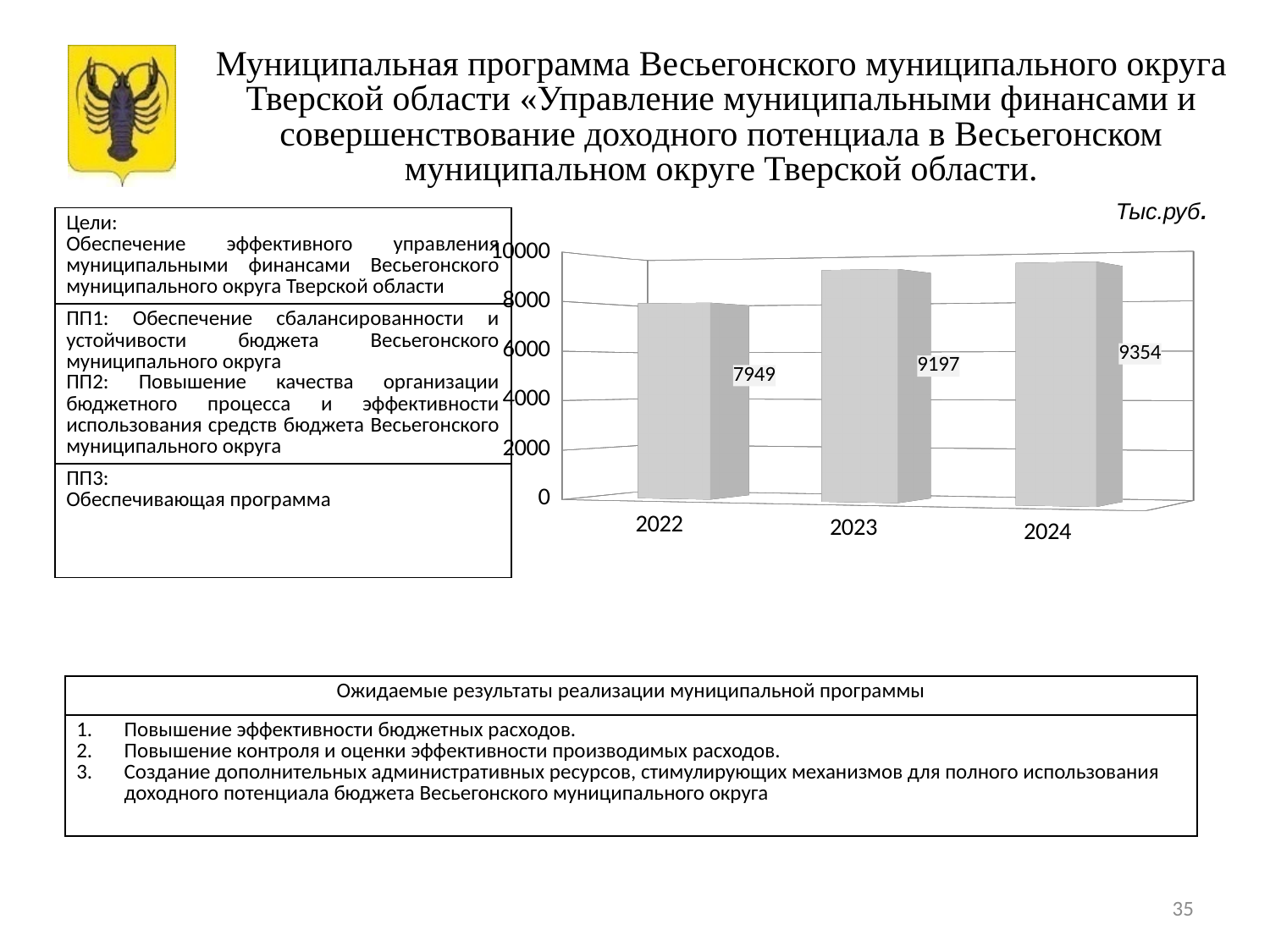
What is the difference between the values for 2024 and 2023? 157 What is the value for 2024? 9354 Is the value for 2022 greater or less than 8000? less Which is larger, the value for 2022 or the value for 2023? 2023 What kind of chart is shown on the slide? bar chart Do the values rise or fall from 2022 to 2024? rise What is the difference between the values for 2023 and 2022? 1248 How many years are shown on the chart? 3 What is the value for 2023? 9197 What is the value for 2022? 7949 Which year has the highest value? 2024 Which year has the lowest value? 2022